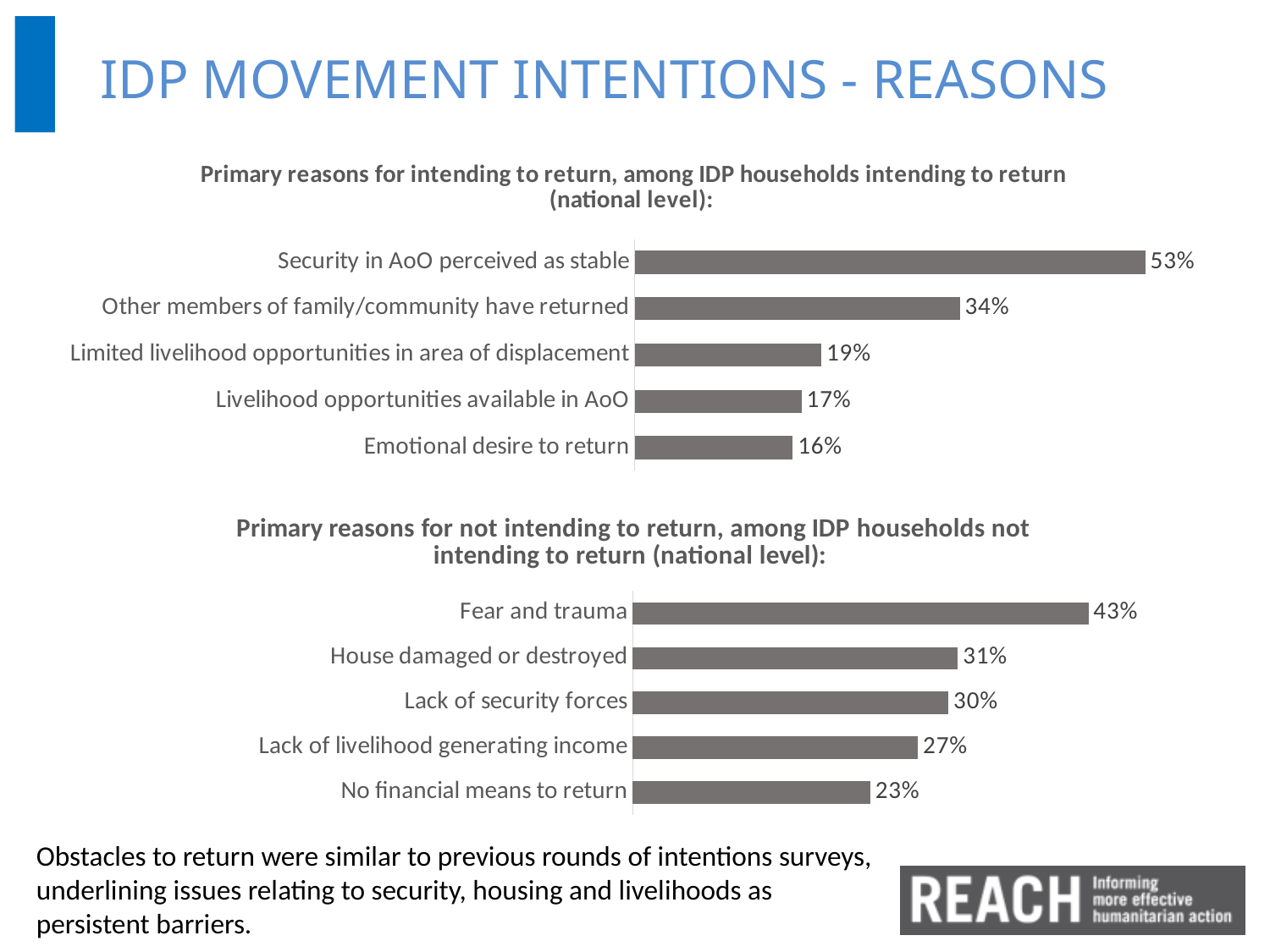
In the bottom chart (primary reasons for not intending to return), what is the difference between 'Fear and trauma' and 'No financial means to return'? 20% How many categories are shown in the bottom chart (primary reasons for not intending to return)? 5 In the top chart (primary reasons for intending to return), what is the value for 'Security in AoO perceived as stable'? 53% What kind of chart is the bottom chart (primary reasons for not intending to return)? Bar chart In the bottom chart (primary reasons for not intending to return), which category has the highest value? Fear and trauma In the bottom chart (primary reasons for not intending to return), which is larger: 'Lack of security forces' or 'Lack of livelihood generating income'? Lack of security forces In the top chart (primary reasons for intending to return), what is the value for 'Emotional desire to return'? 16% In the top chart (primary reasons for intending to return), what is the difference between 'Security in AoO perceived as stable' and 'Other members of family/community have returned'? 19% What is the title of the top chart on the slide? Primary reasons for intending to return, among IDP households intending to return (national level): In the top chart (primary reasons for intending to return), which category has the lowest value? Emotional desire to return In the bottom chart (primary reasons for not intending to return), what is the value for 'House damaged or destroyed'? 31% How many categories are shown in the top chart (primary reasons for intending to return)? 5